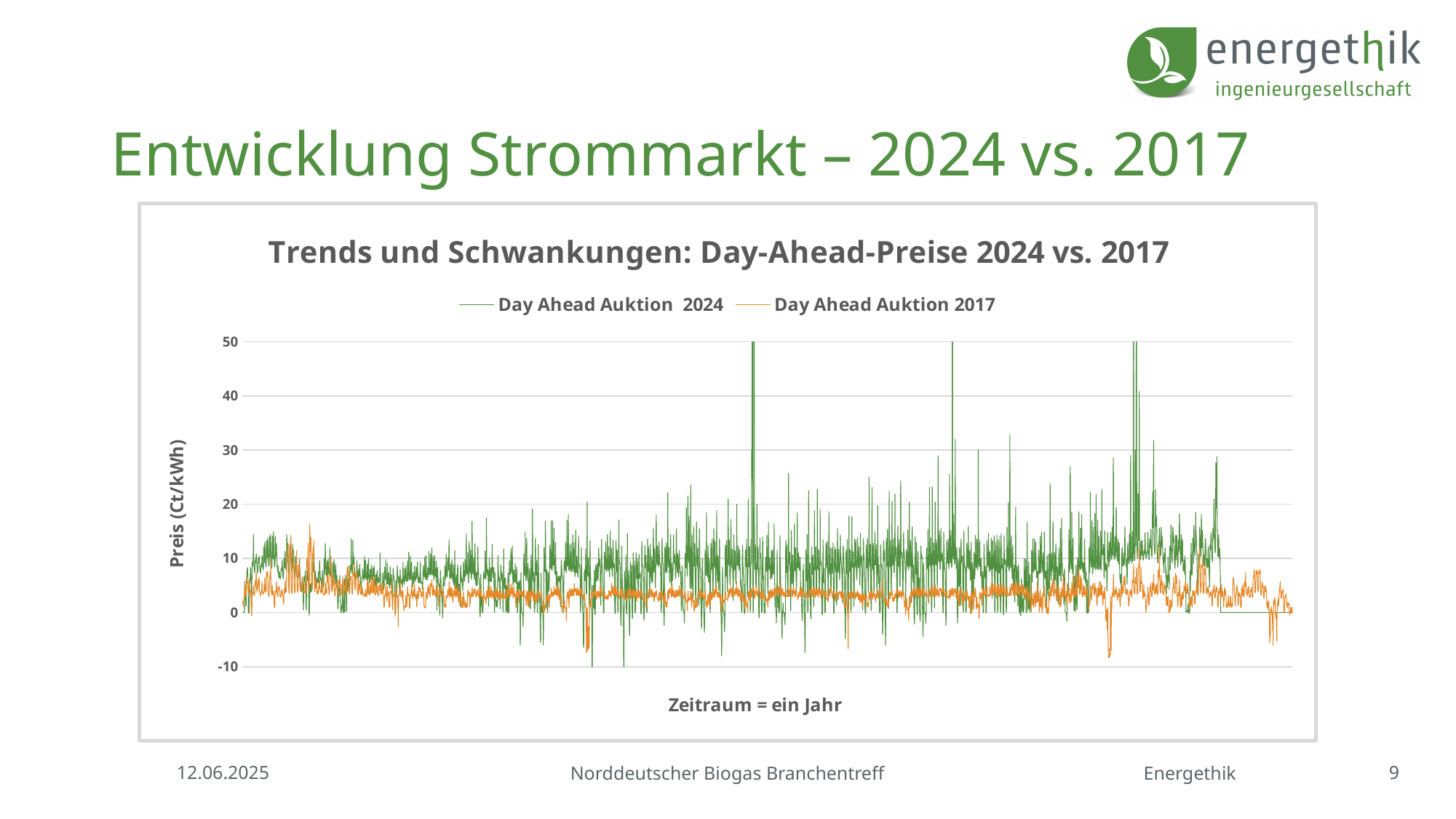
Which series generally lies higher on the chart across the year, 2024 or 2017? Day Ahead Auktion 2024 Is the highest value of the Day Ahead Auktion 2017 series greater or less than 20? less How many series does the legend list? 2 What kind of chart is shown on the slide? Line chart What is the highest tick value shown on the y axis? 50 Is the lowest value of the Day Ahead Auktion 2024 series greater or less than -5? less Is the lowest value of the Day Ahead Auktion 2017 series greater or less than 0? less Which series reaches the higher peak values, Day Ahead Auktion 2024 or Day Ahead Auktion 2017? Day Ahead Auktion 2024 What is the title of the chart? Trends und Schwankungen: Day-Ahead-Preise 2024 vs. 2017 Which series is drawn in orange? Day Ahead Auktion 2017